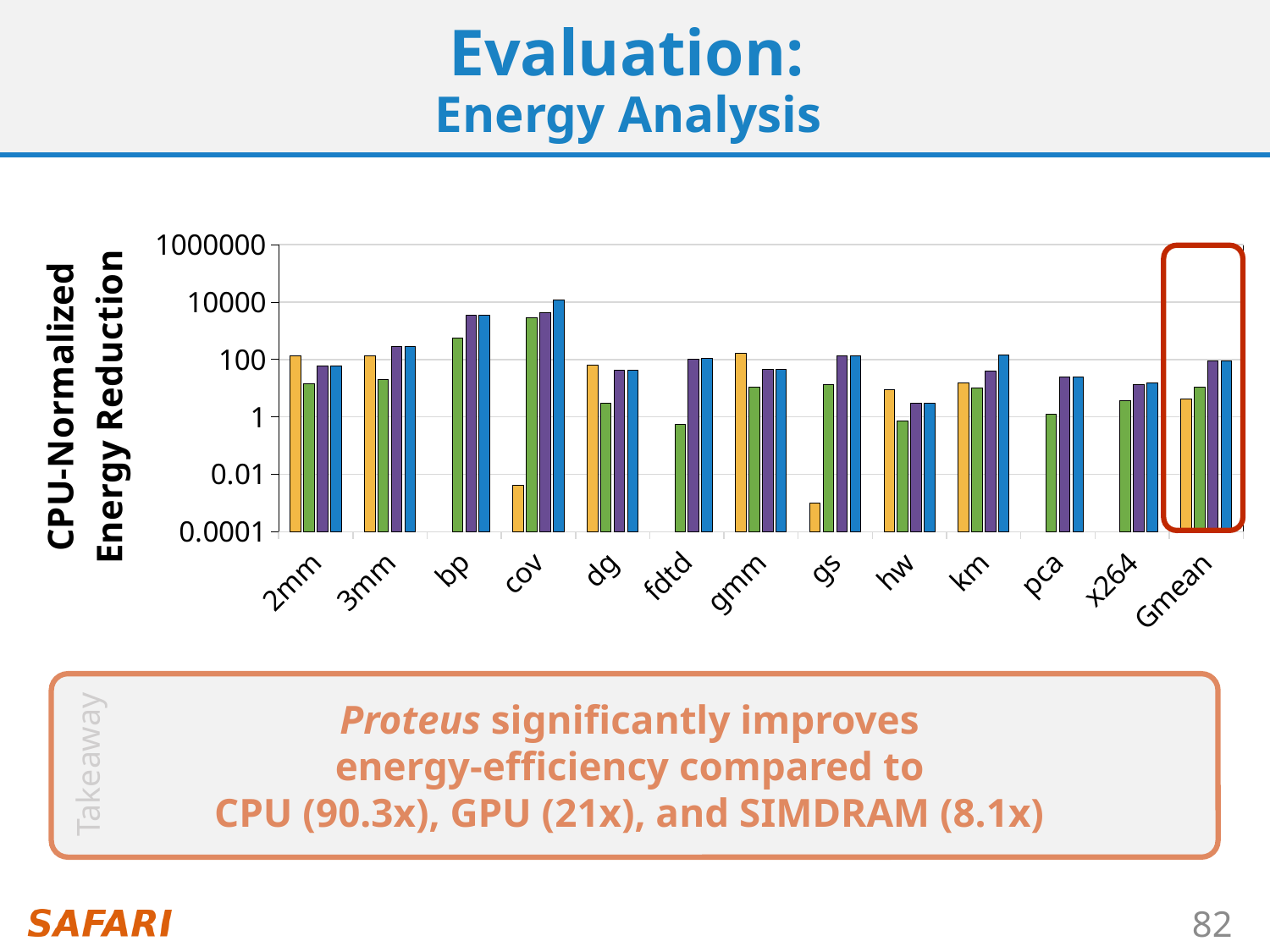
For cov, which is larger: the blue bar or the yellow bar? the blue bar Is the value of the yellow bar for hw greater or less than 1? greater Is the value of the purple bar for bp greater or less than 100? greater Is the value of the green bar for fdtd greater or less than 1? less What is the label of the y axis of the chart? CPU-Normalized Energy Reduction Which category has the lowest yellow bar? gs How many categories are shown along the x axis of the chart? 13 Which category has the tallest blue bar? cov What kind of chart is shown on the slide? bar chart For fdtd, which is larger: the green bar or the blue bar? the blue bar Which category on the x axis is highlighted with a red box? Gmean